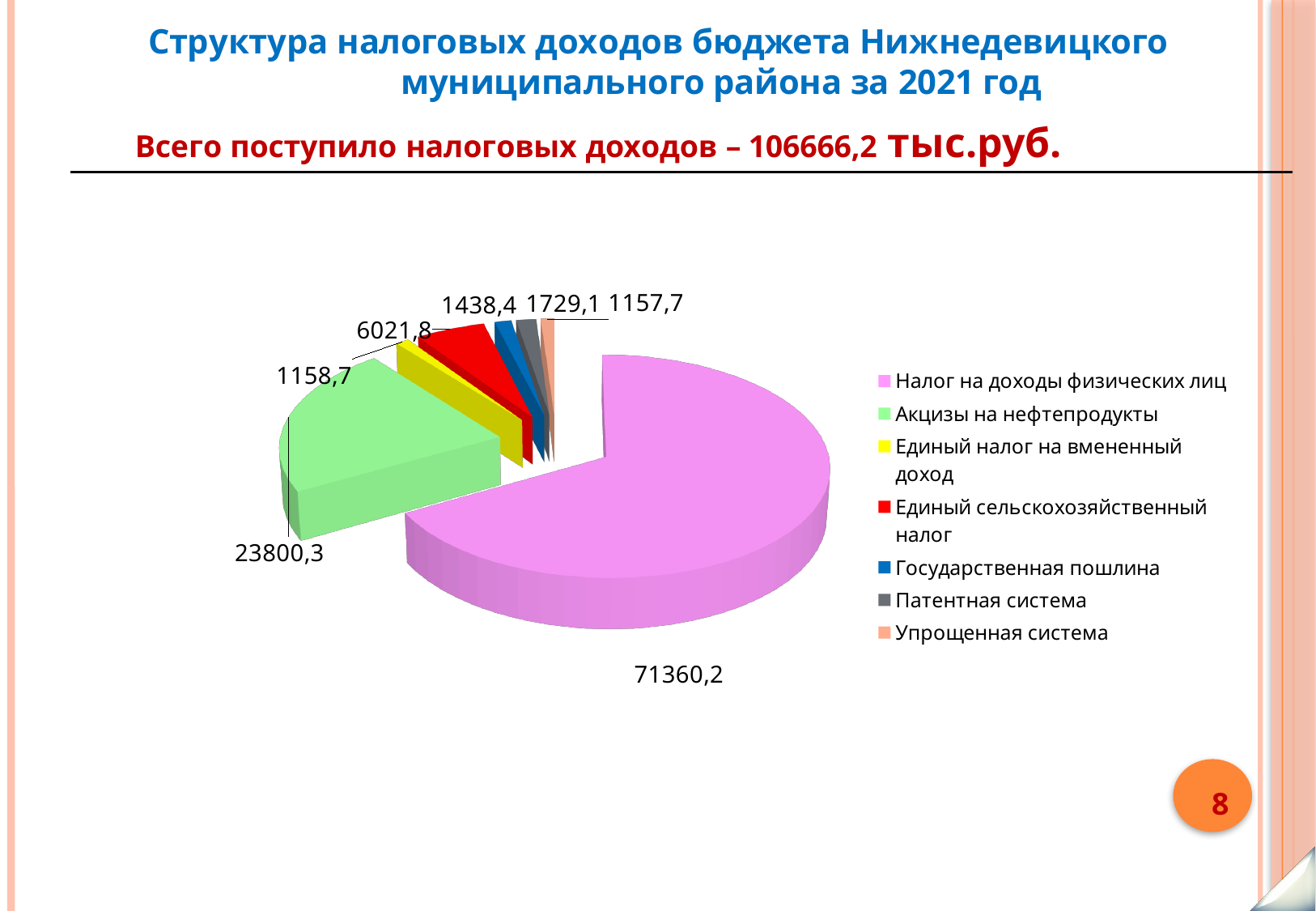
What total amount of tax revenue is stated on the slide? 106666,2 тыс.руб. What is the value for Акцизы на нефтепродукты? 23800,3 How many slices does the pie chart have? 7 Which category has the largest slice of the pie? Налог на доходы физических лиц Which is larger, Единый налог на вмененный доход or Единый сельскохозяйственный налог? Единый сельскохозяйственный налог What is the value for Налог на доходы физических лиц? 71360,2 What kind of chart is shown on the slide? pie chart What is the value for Единый налог на вмененный доход? 1158,7 What is the difference between the values for Налог на доходы физических лиц and Акцизы на нефтепродукты? 47559,9 How many entries does the legend list? 7 Which is larger, Налог на доходы физических лиц or Акцизы на нефтепродукты? Налог на доходы физических лиц What colour is the slice for Акцизы на нефтепродукты? green